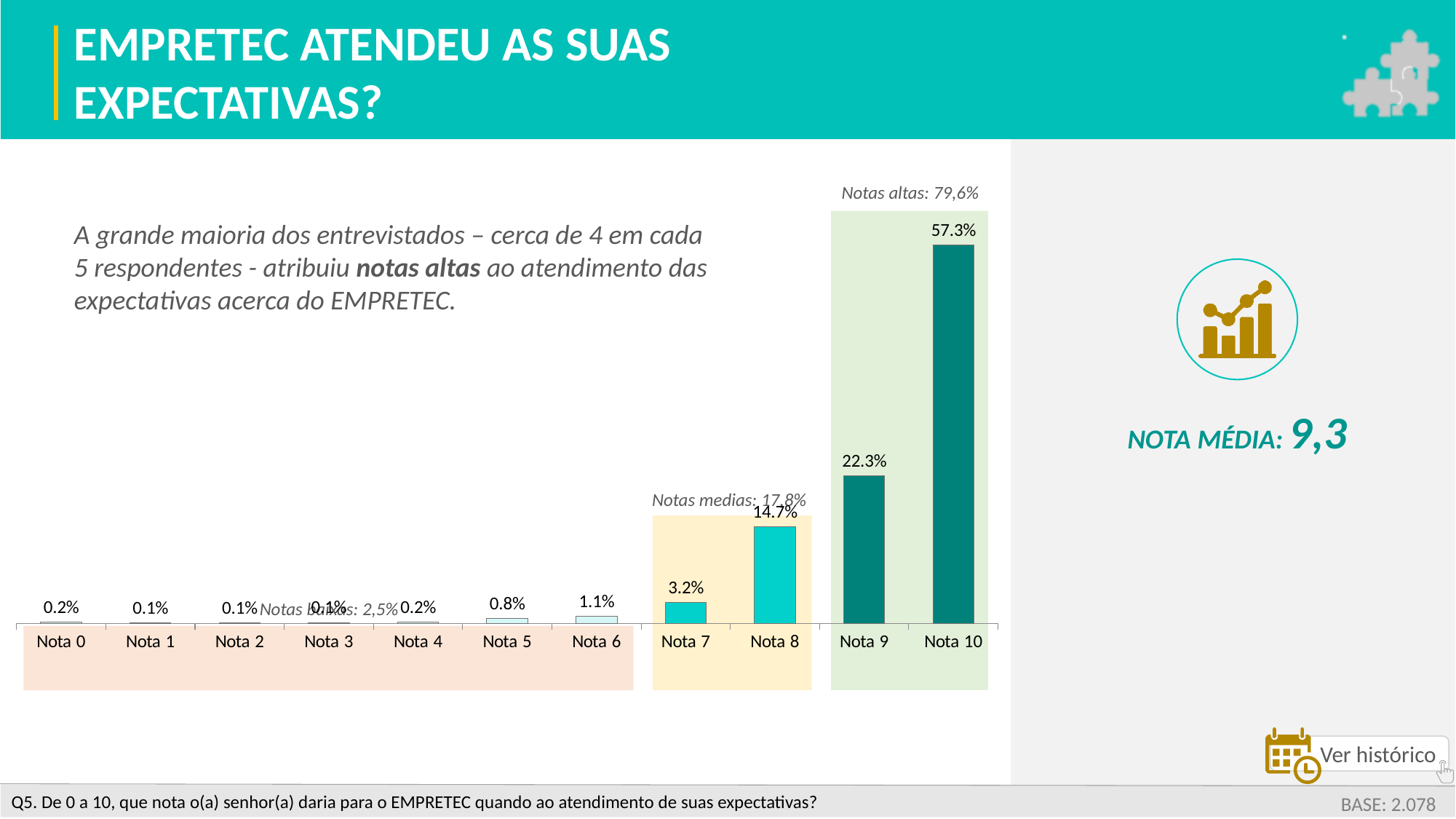
Which is larger, the value for Nota 9 or the value for Nota 8? Nota 9 What is the value for Nota 6? 1.1% What is the combined share labelled for 'Notas altas'? 79,6% Which category has the highest value? Nota 10 What is the value for Nota 7? 3.2% What kind of chart is shown on the slide? Bar chart What is the value for Nota 10? 57.3% What is the 'Nota média' shown on the slide? 9,3 What is the difference between the values for Nota 8 and Nota 7? 11.5% What is the difference between the values for Nota 10 and Nota 9? 35.0% How many categories (notas) are shown on the x axis? 11 What is the value for Nota 8? 14.7%